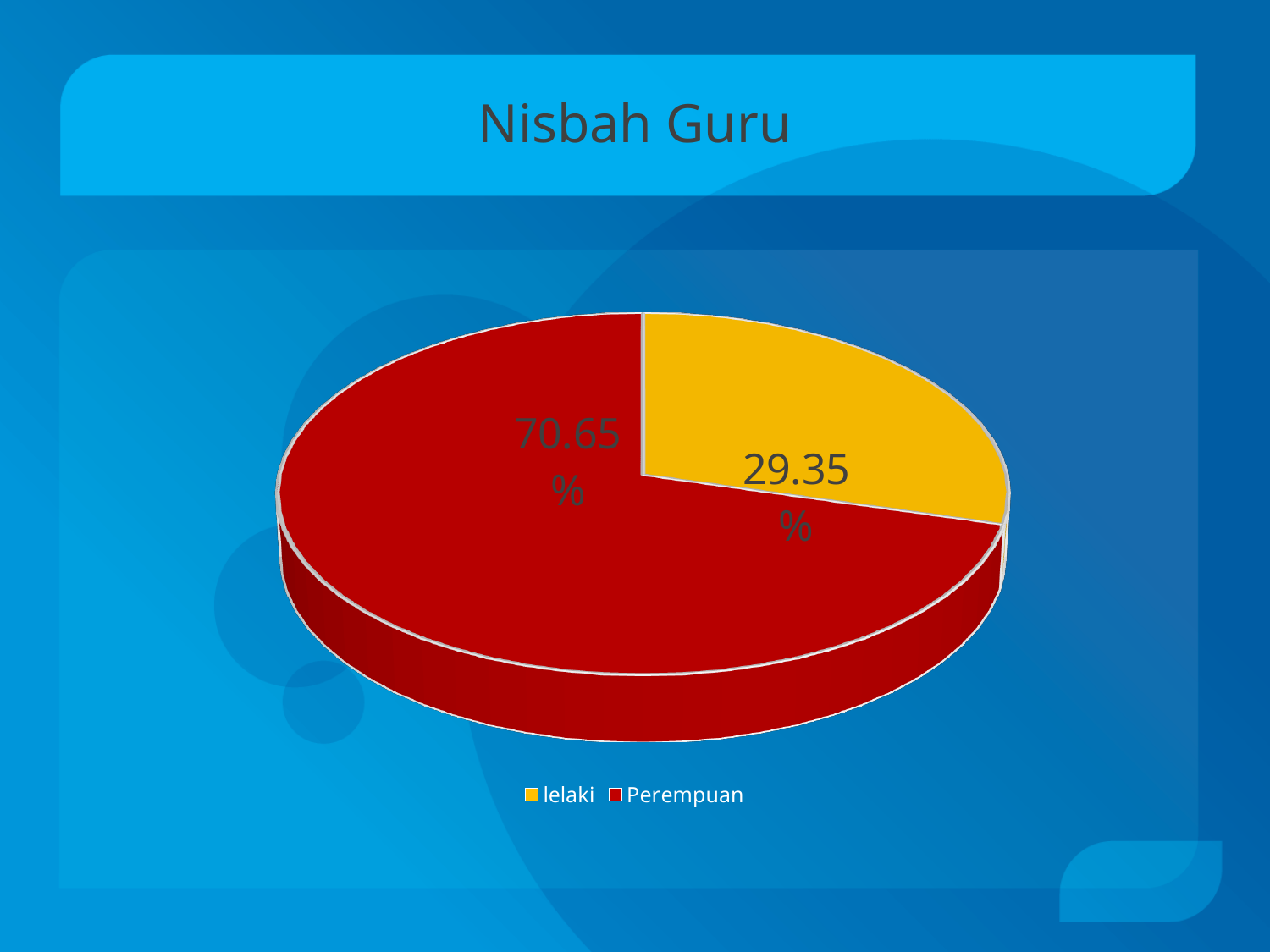
How many entries does the legend list? 2 What is the difference between the Perempuan share and the lelaki share? 41.30% How many slices does the pie chart have? 2 Which category has the smallest share of the pie? lelaki What is the share of the pie for Perempuan? 70.65% What percentage of the pie is labelled for Perempuan? 70.65% What colour is the slice for lelaki? yellow Which is larger, the share for lelaki or the share for Perempuan? Perempuan Which category has the largest share of the pie? Perempuan What percentage of the pie is labelled for lelaki? 29.35% What kind of chart is shown on the slide? pie chart What is the title of the chart? Nisbah Guru